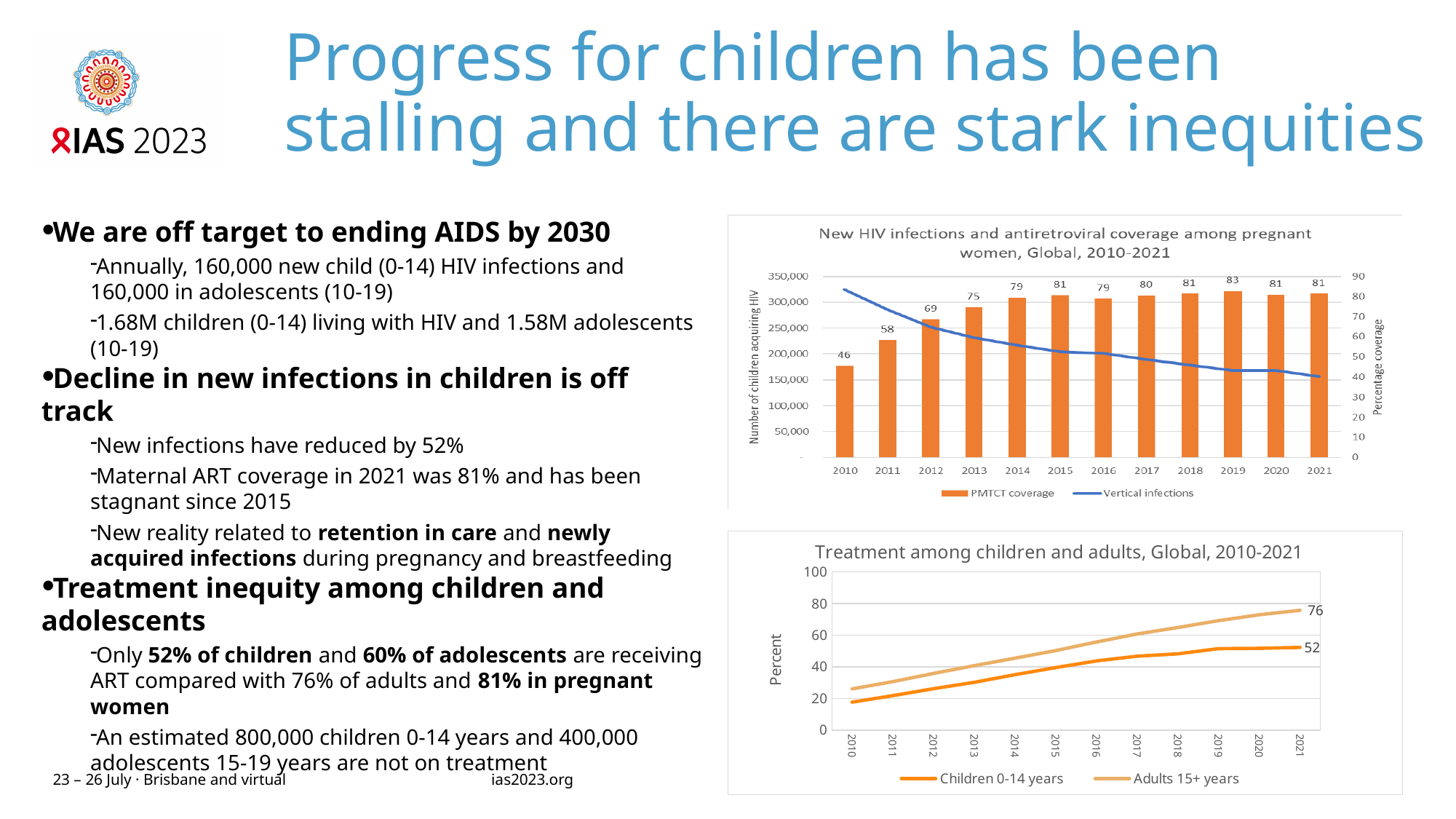
In the bottom chart (Treatment among children and adults), what is the value for Children 0-14 years in 2021? 52 In the top chart (New HIV infections and antiretroviral coverage among pregnant women), which year has the highest PMTCT coverage? 2019 In the top chart (New HIV infections and antiretroviral coverage among pregnant women), which year has the lowest PMTCT coverage? 2010 In the bottom chart (Treatment among children and adults), what is the difference between Adults 15+ years and Children 0-14 years in 2021? 24 In the top chart (New HIV infections and antiretroviral coverage among pregnant women), by how much did PMTCT coverage increase from 2010 to 2021? 35 In the top chart (New HIV infections and antiretroviral coverage among pregnant women), what is the PMTCT coverage value for 2010? 46 What kind of chart is the bottom chart (Treatment among children and adults)? line chart In the top chart (New HIV infections and antiretroviral coverage among pregnant women), does the Vertical infections line rise or fall from 2010 to 2021? fall In the bottom chart (Treatment among children and adults), is the value for Adults 15+ years in 2010 greater or less than 40? less In the top chart (New HIV infections and antiretroviral coverage among pregnant women), how many years are shown on the x axis? 12 In the top chart (New HIV infections and antiretroviral coverage among pregnant women), which year has higher PMTCT coverage, 2012 or 2013? 2013 In the top chart (New HIV infections and antiretroviral coverage among pregnant women), what is the PMTCT coverage value for 2019? 83